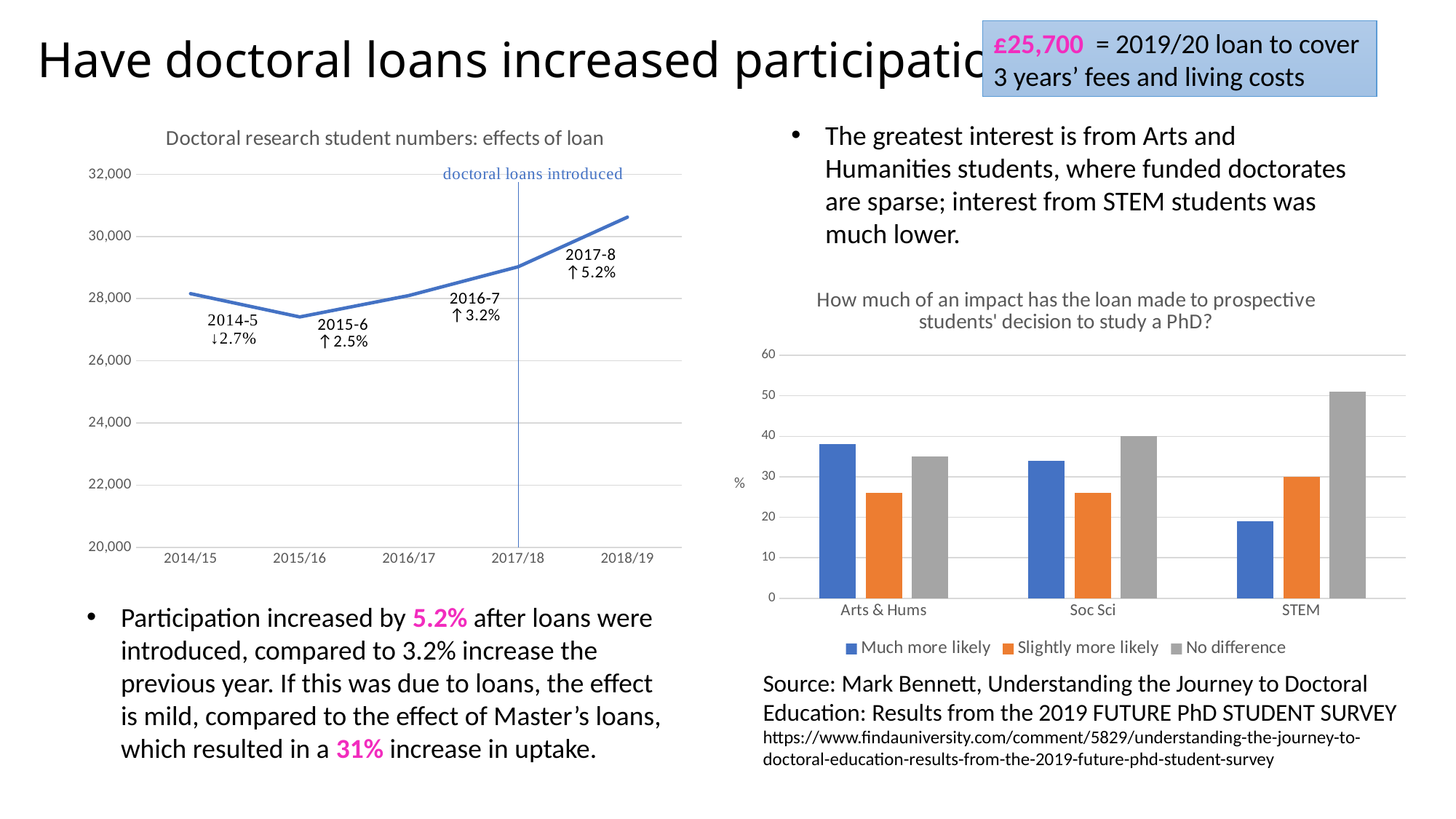
In the chart 'How much of an impact has the loan made to prospective students' decision to study a PhD?', how many series does the legend list? 3 In the chart 'Doctoral research student numbers: effects of loan', do student numbers rise or fall from 2015/16 to 2018/19? rise In the chart 'Doctoral research student numbers: effects of loan', how many academic years are shown on the x axis? 5 In the chart 'Doctoral research student numbers: effects of loan', is the value for 2015/16 greater or less than 28,000? less In the chart 'Doctoral research student numbers: effects of loan', is the value for 2018/19 greater or less than 30,000? greater In the chart 'How much of an impact has the loan made to prospective students' decision to study a PhD?', which subject group has the highest 'No difference' value? STEM In the chart 'Doctoral research student numbers: effects of loan', what percentage change is labelled for 2014-5? ↓2.7% In the chart 'How much of an impact has the loan made to prospective students' decision to study a PhD?', is the 'Much more likely' value for STEM greater or less than 30? less What type of chart is the chart titled 'Doctoral research student numbers: effects of loan'? line chart In the chart 'Doctoral research student numbers: effects of loan', which year has the lowest student numbers? 2015/16 In the chart 'Doctoral research student numbers: effects of loan', what percentage change is labelled for 2017-8? ↑5.2% What type of chart is the chart titled 'How much of an impact has the loan made to prospective students' decision to study a PhD?'? bar chart